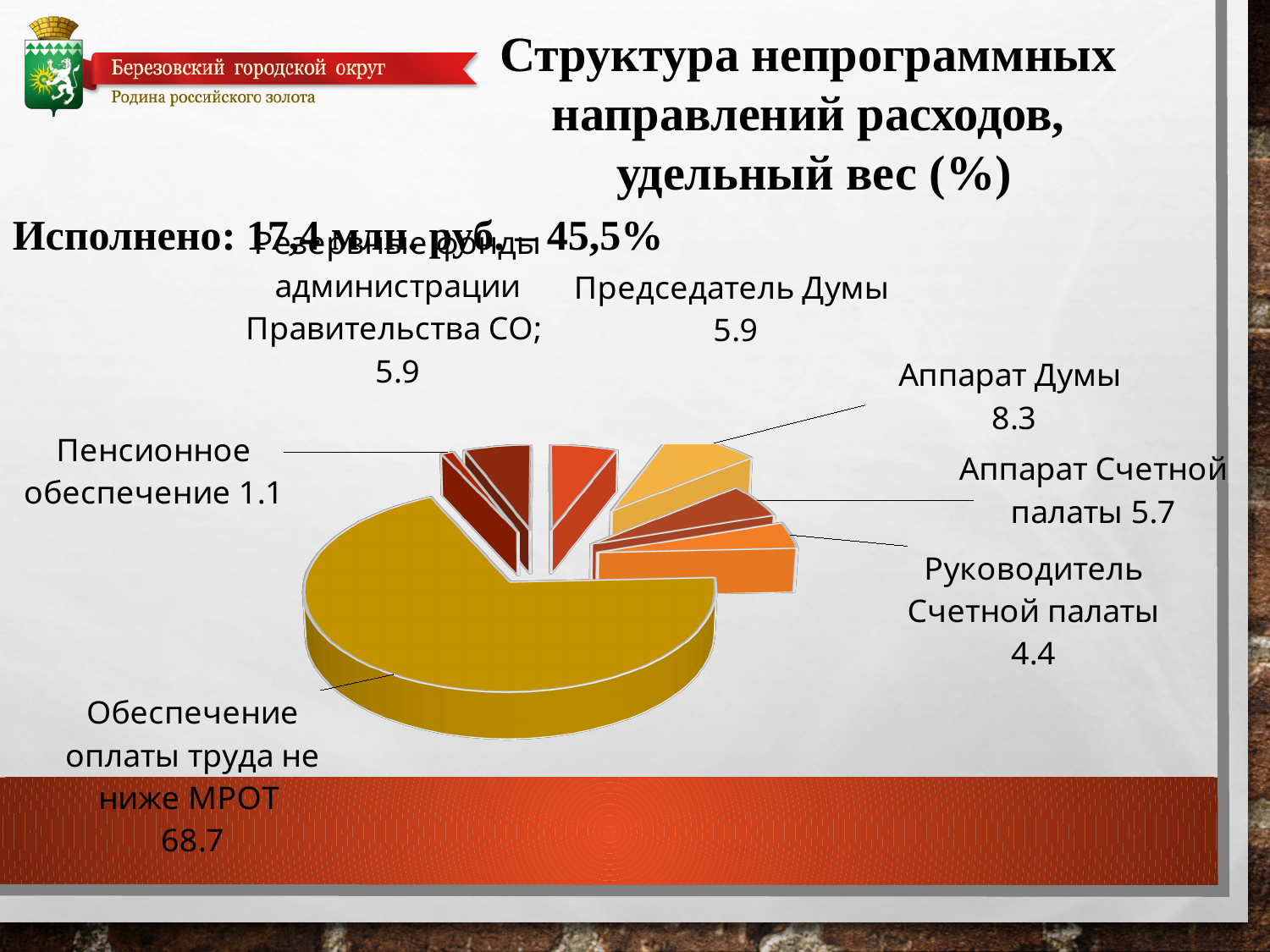
What is the title of the chart on the slide? Структура непрограммных направлений расходов, удельный вес (%) How many slices does the pie chart have? 7 What is the share for Обеспечение оплаты труда не ниже МРОТ? 68.7 What kind of chart is shown on the slide? pie chart What is the share for Пенсионное обеспечение? 1.1 What is the share for Аппарат Думы? 8.3 Which is larger: the share for Председатель Думы or the share for Руководитель Счетной палаты? Председатель Думы Which category has the largest share of the pie? Обеспечение оплаты труда не ниже МРОТ Which category has the smallest share of the pie? Пенсионное обеспечение What is the difference between the shares of Аппарат Думы and Аппарат Счетной палаты? 2.6 What is the share for Аппарат Счетной палаты? 5.7 What is the share for Руководитель Счетной палаты? 4.4